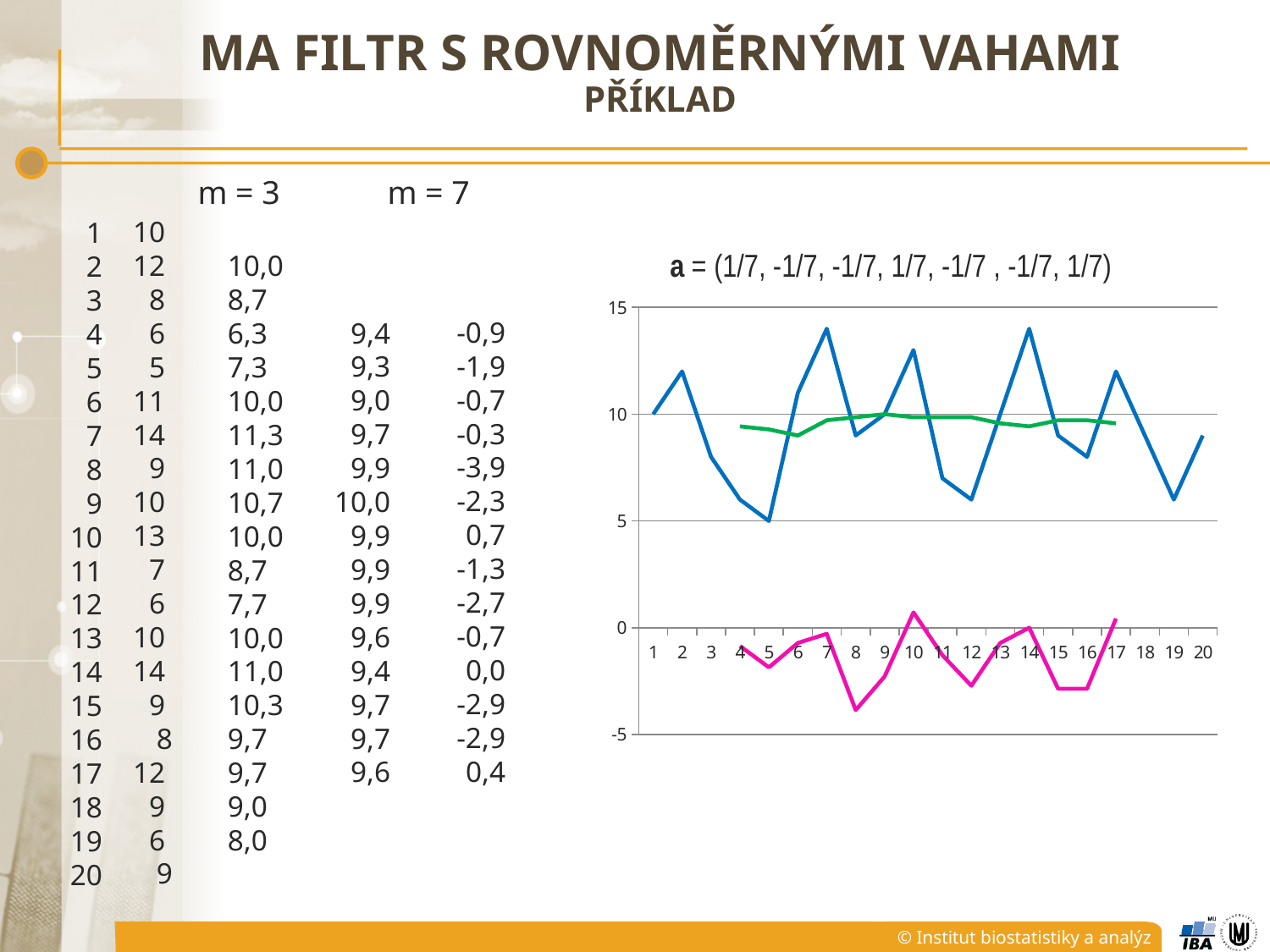
Is the value of the blue line at x = 19 greater or less than 10? less What kind of chart is shown on the slide? line chart How many points are labelled along the x axis of the chart? 20 Is the value of the green line at x = 4 greater or less than 10? less How many lines are plotted on the chart? 3 At which x value does the magenta line reach its lowest point? 8 Does the blue line rise or fall from x = 17 to x = 19? fall What is the value of the blue line at x = 5? 5 What is the value of the blue line at x = 1? 10 What is the title printed above the chart? a = (1/7, -1/7, -1/7, 1/7, -1/7, -1/7, 1/7) Is the value of the magenta line at x = 8 greater or less than 0? less